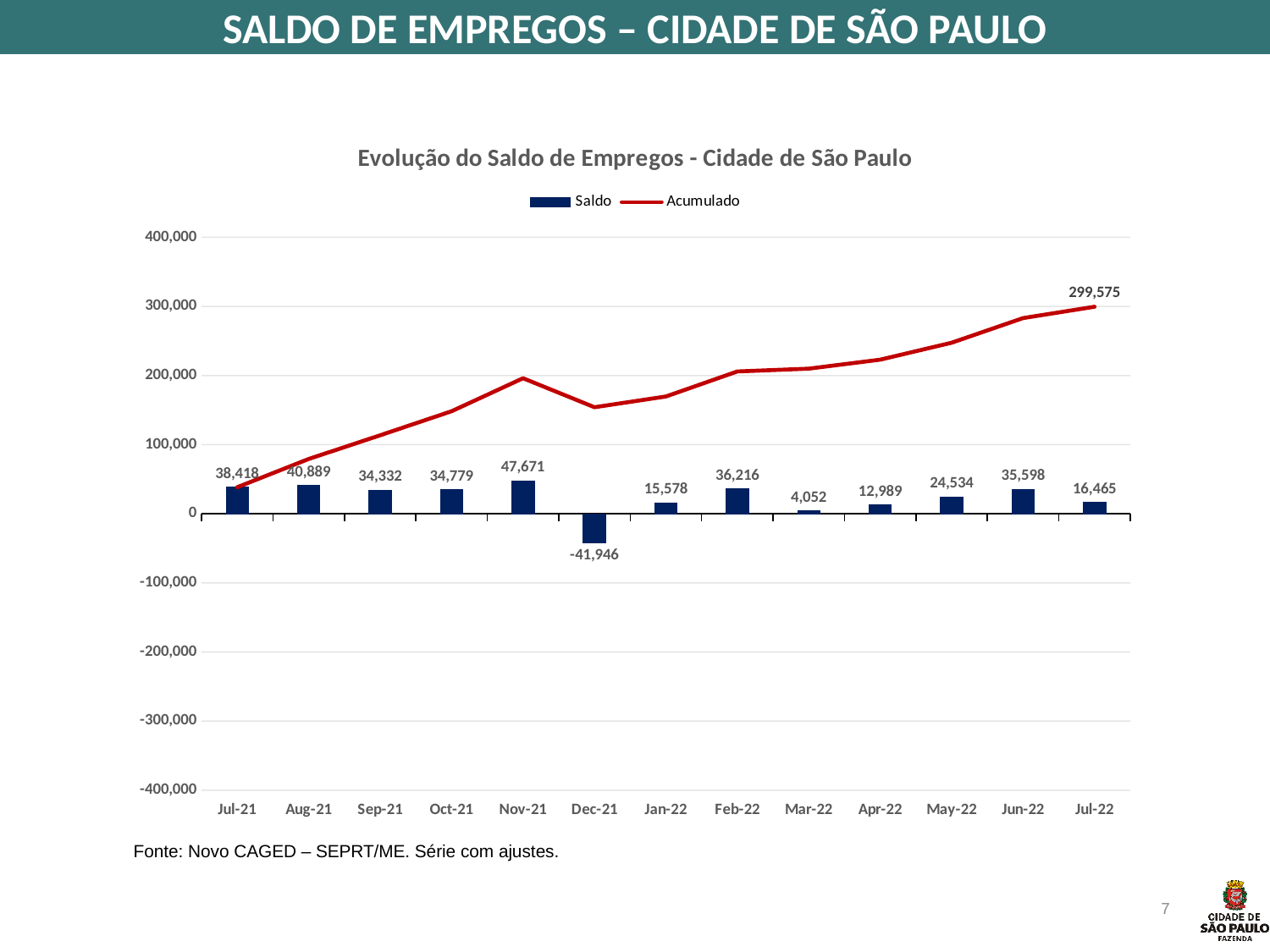
What is the Acumulado value shown for Jul-22? 299,575 Does the Acumulado line generally rise or fall from Jul-21 to Jul-22? rise Which month has a larger Saldo value, Aug-21 or Mar-22? Aug-21 Is the Acumulado value for Jun-22 greater or less than 200,000? greater How many months are shown on the x axis? 13 What is the Saldo value for Nov-21? 47,671 What is the difference between the Saldo values for Nov-21 and Jul-22? 31,206 How many series does the legend list? 2 What is the Saldo value for Dec-21? -41,946 Which month has the highest Saldo value? Nov-21 What kind of chart is this? Combined bar and line chart Which month has the lowest Saldo value? Dec-21